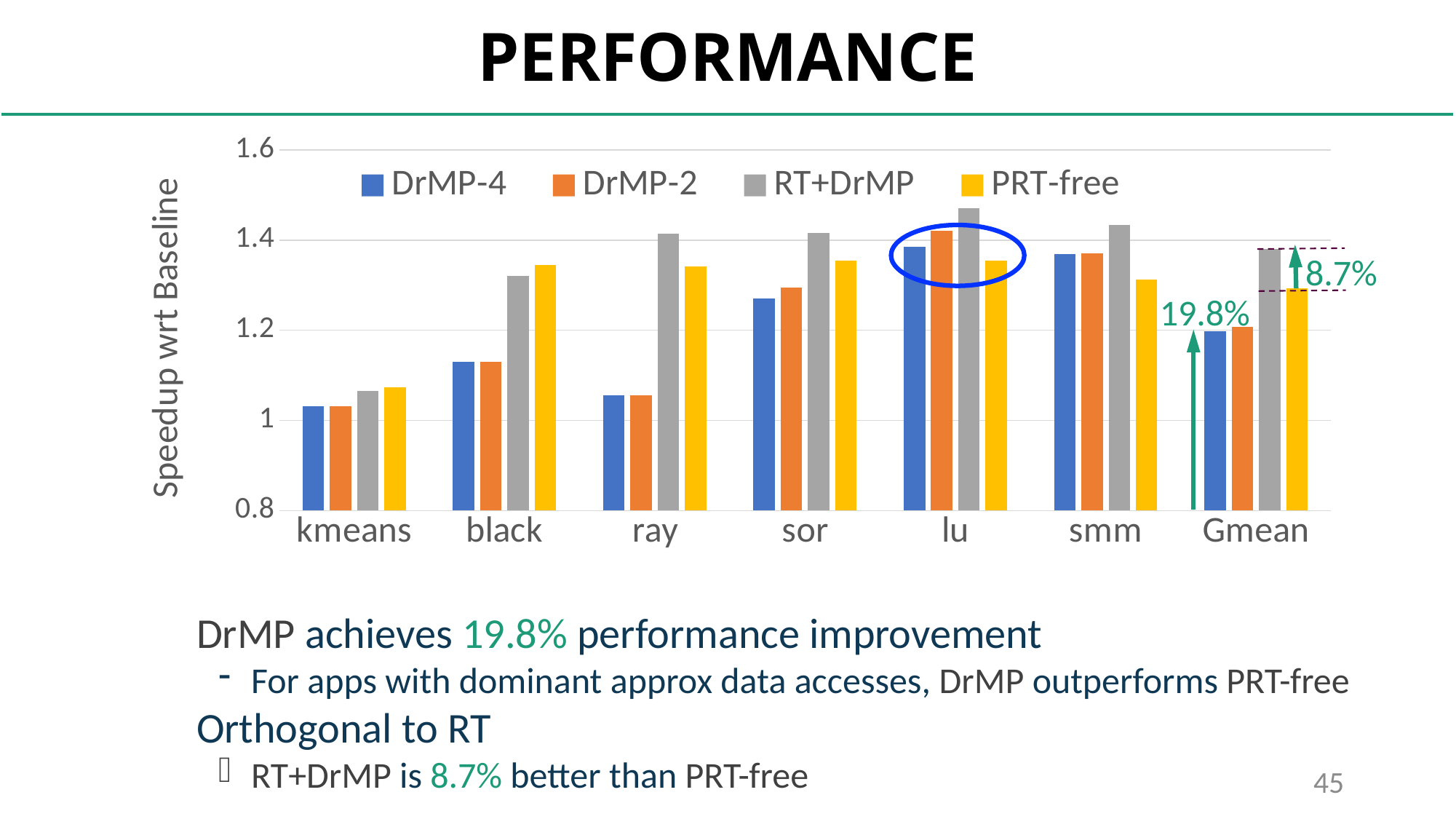
What is the label of the y axis? Speedup wrt Baseline Is the RT+DrMP value for lu greater or less than 1.4? greater Is the DrMP-4 value for ray greater or less than 1.2? less For ray, which is larger: the RT+DrMP value or the PRT-free value? RT+DrMP Which category has the lowest DrMP-4 speedup? kmeans Which has the larger DrMP-2 value, kmeans or black? black What kind of chart is shown on the slide? bar chart Which category has the highest RT+DrMP speedup? lu What percentage improvement is annotated above the Gmean DrMP-4 bar? 19.8% How many series does the legend list? 4 How many categories are shown on the x axis? 7 Is the PRT-free value for smm greater or less than 1.4? less